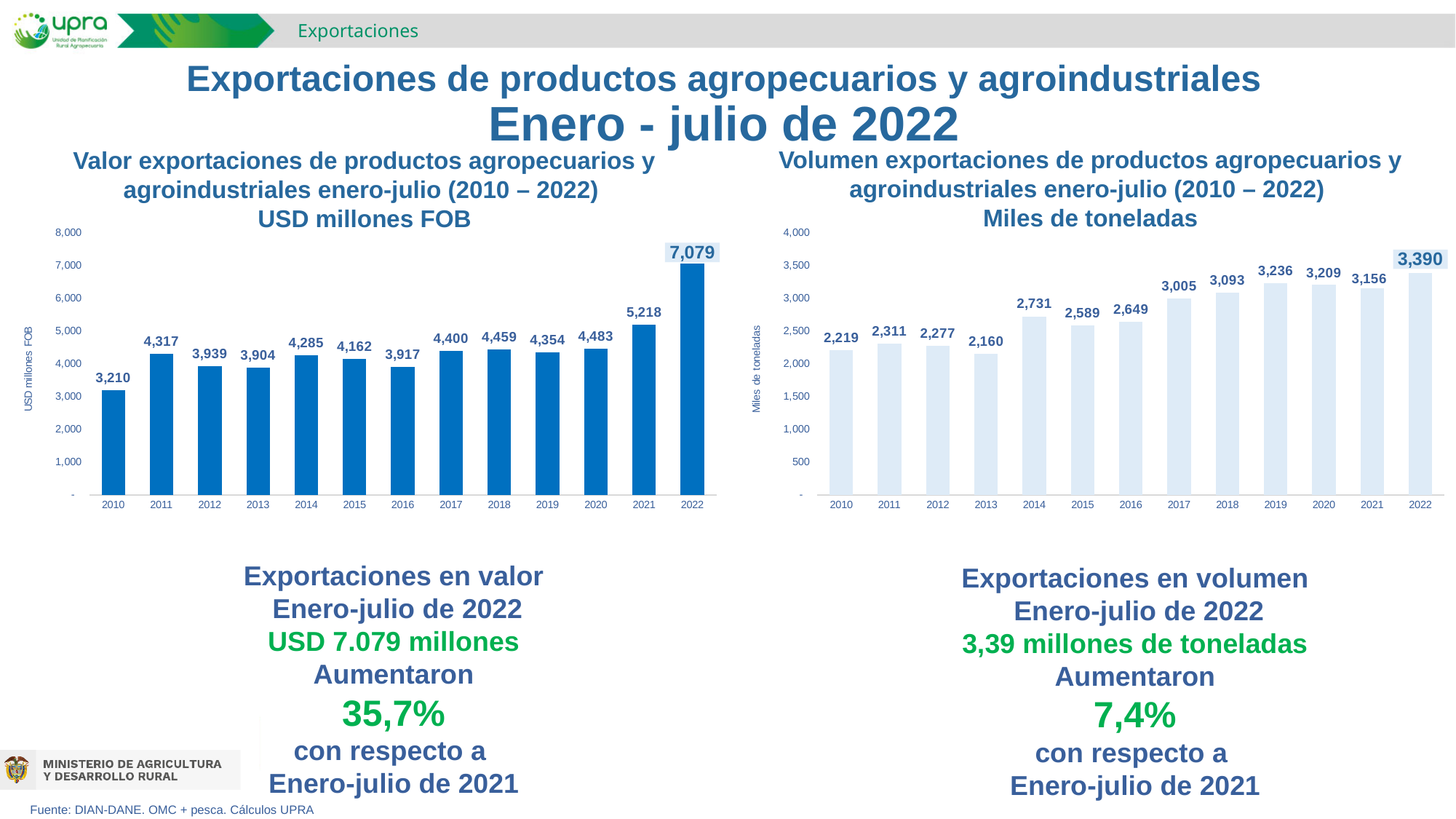
In the right chart (Volumen exportaciones, Miles de toneladas), is the value for 2017 greater or less than 3,000? greater In the right chart (Volumen exportaciones, Miles de toneladas), which year has the highest value? 2022 In the right chart (Volumen exportaciones, Miles de toneladas), what is the difference between the 2019 and 2018 values? 143 In the left chart (Valor exportaciones, USD millones FOB), which year has the lowest value? 2010 In the left chart (Valor exportaciones, USD millones FOB), what is the value for 2022? 7,079 In the left chart (Valor exportaciones, USD millones FOB), what is the value for 2010? 3,210 What kind of chart is the right chart (Volumen exportaciones, Miles de toneladas)? bar chart In the left chart (Valor exportaciones, USD millones FOB), how many years are plotted? 13 In the right chart (Volumen exportaciones, Miles de toneladas), what is the value for 2013? 2,160 In the left chart (Valor exportaciones, USD millones FOB), what is the difference between the 2022 and 2021 values? 1,861 In the left chart (Valor exportaciones, USD millones FOB), which is larger, the value for 2011 or the value for 2012? 2011 In the right chart (Volumen exportaciones, Miles de toneladas), what is the y-axis label? Miles de toneladas